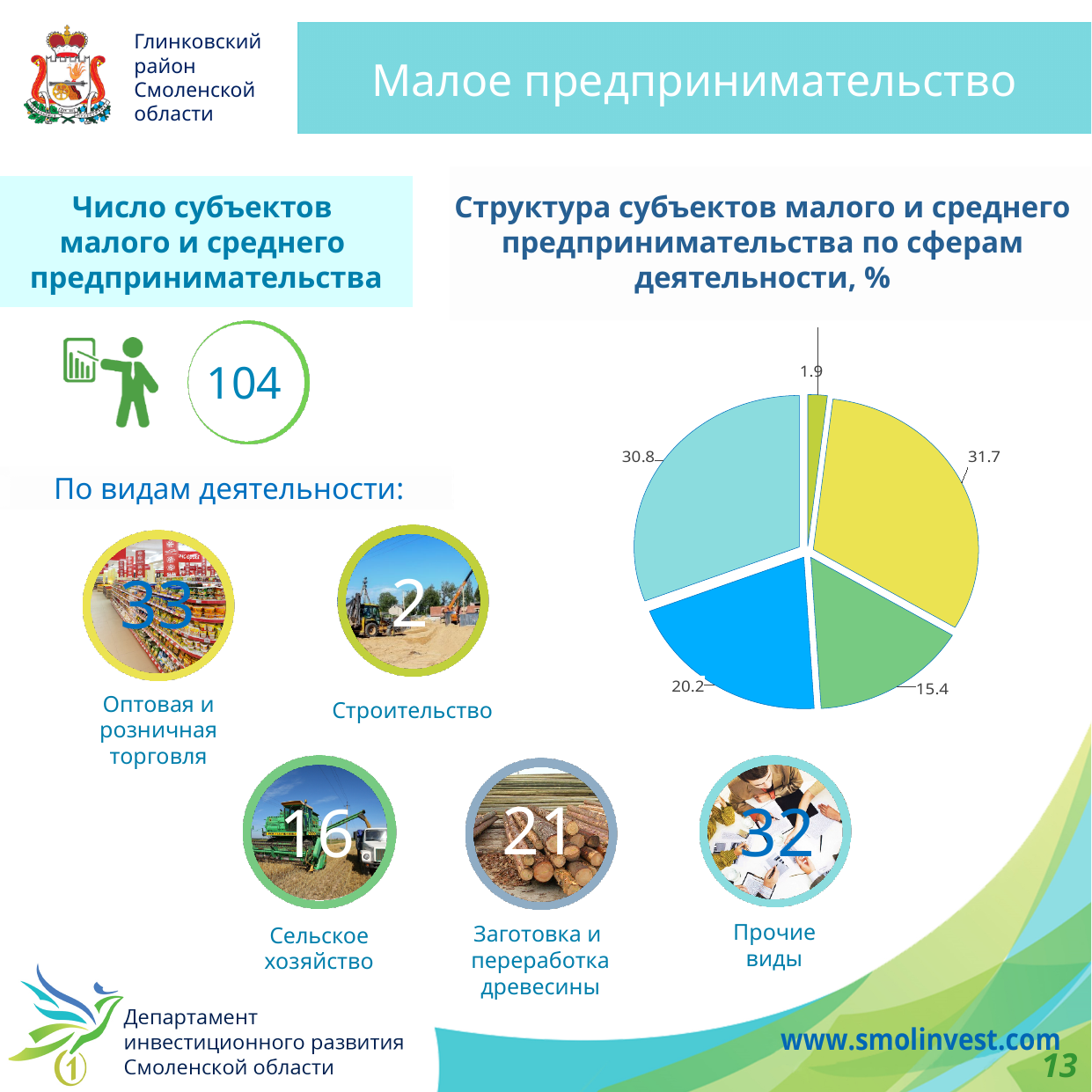
What is the second-largest value labeled on the pie chart? 30.8 What is the smallest value labeled on the pie chart? 1.9 What is the largest value labeled on the pie chart? 31.7 What kind of chart is shown under the title "Структура субъектов малого и среднего предпринимательства по сферам деятельности, %"? pie chart What value is labeled on the green slice of the pie chart? 15.4 How many slices does the pie chart have? 5 What value is labeled on the yellow slice of the pie chart? 31.7 What is the title of the pie chart? Структура субъектов малого и среднего предпринимательства по сферам деятельности, % What is the difference between the values 30.8 and 20.2 labeled on the pie chart? 10.6 What is the sum of all the values labeled on the pie chart? 100 What is the difference between the largest and smallest values labeled on the pie chart? 29.8 On the pie chart, which is larger: the slice labeled 20.2 or the slice labeled 15.4? the slice labeled 20.2